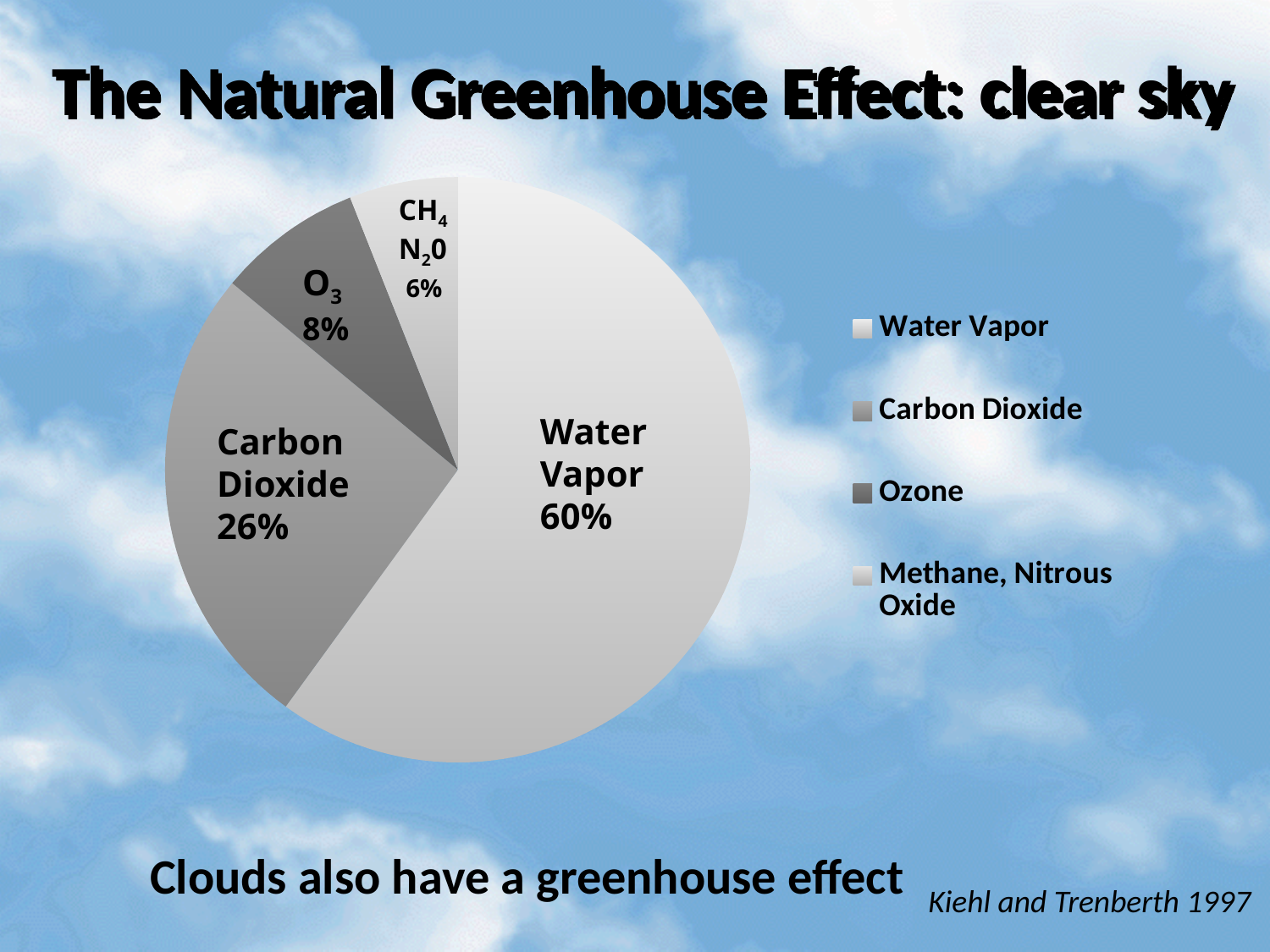
What share of the pie does Carbon Dioxide account for? 26% What share of the pie do Methane and Nitrous Oxide (CH4, N2O) account for? 6% How many entries does the legend list? 4 Which is larger, the Ozone slice or the Methane, Nitrous Oxide slice? Ozone What share of the pie does Water Vapor account for? 60% Which slice of the pie is the smallest? Methane, Nitrous Oxide What type of chart is shown on the slide? Pie chart How many slices does the pie chart have? 4 Which slice of the pie is the largest? Water Vapor What is the title of the slide containing the pie chart? The Natural Greenhouse Effect: clear sky What is the difference in percentage points between the Water Vapor slice and the Carbon Dioxide slice? 34